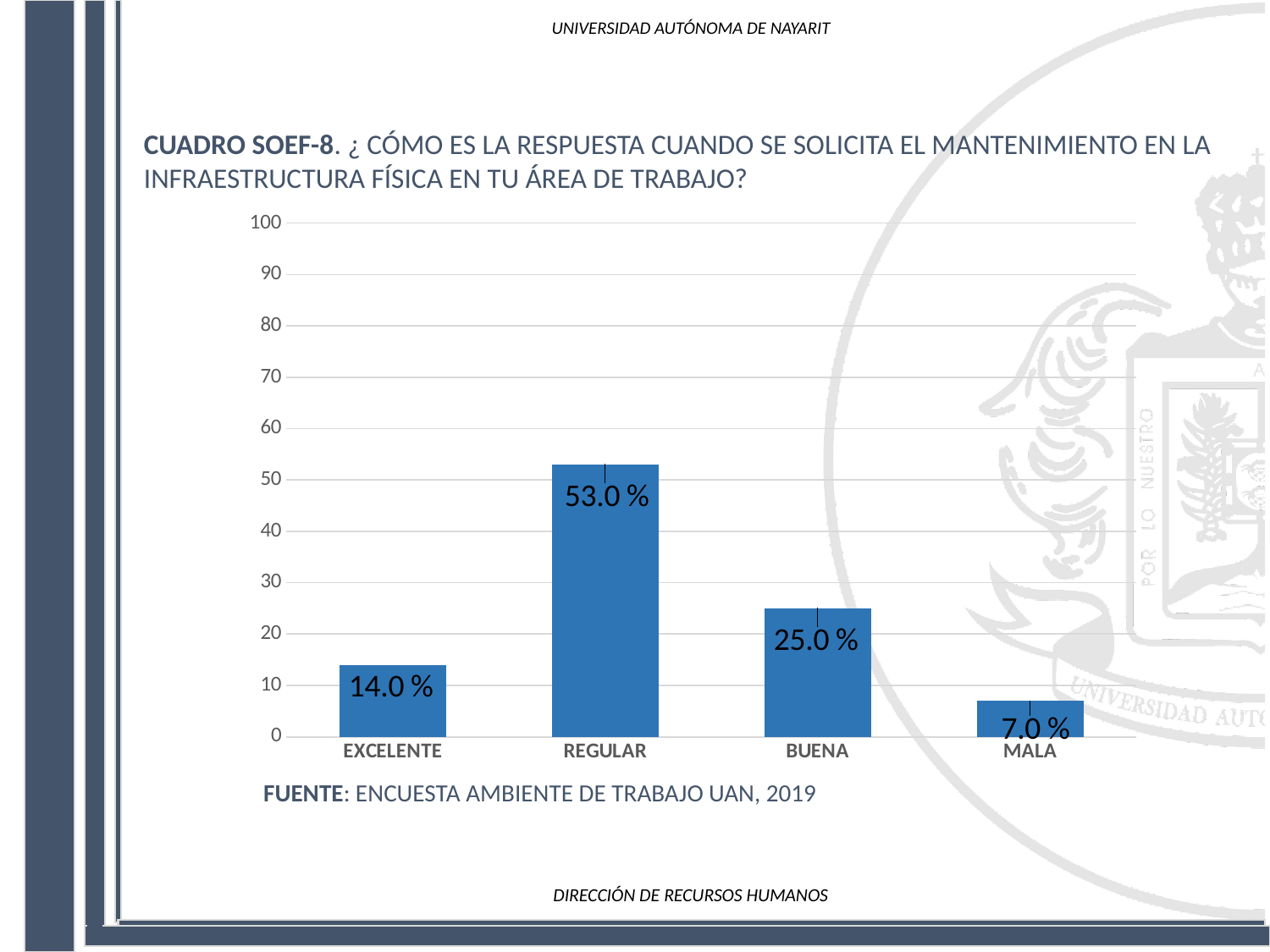
Which category has the lowest value? MALA What is the value for REGULAR? 53.0 % Is the value for REGULAR greater or less than 50? greater Which category has the highest value? REGULAR How many categories are shown on the x axis? 4 What is the value for EXCELENTE? 14.0 % Which is larger, the value for EXCELENTE or the value for BUENA? BUENA What is the value for MALA? 7.0 % What is the difference between the values for REGULAR and BUENA? 28.0 % What kind of chart is shown on the slide? bar chart What is the value for BUENA? 25.0 % What source is cited below the chart? ENCUESTA AMBIENTE DE TRABAJO UAN, 2019